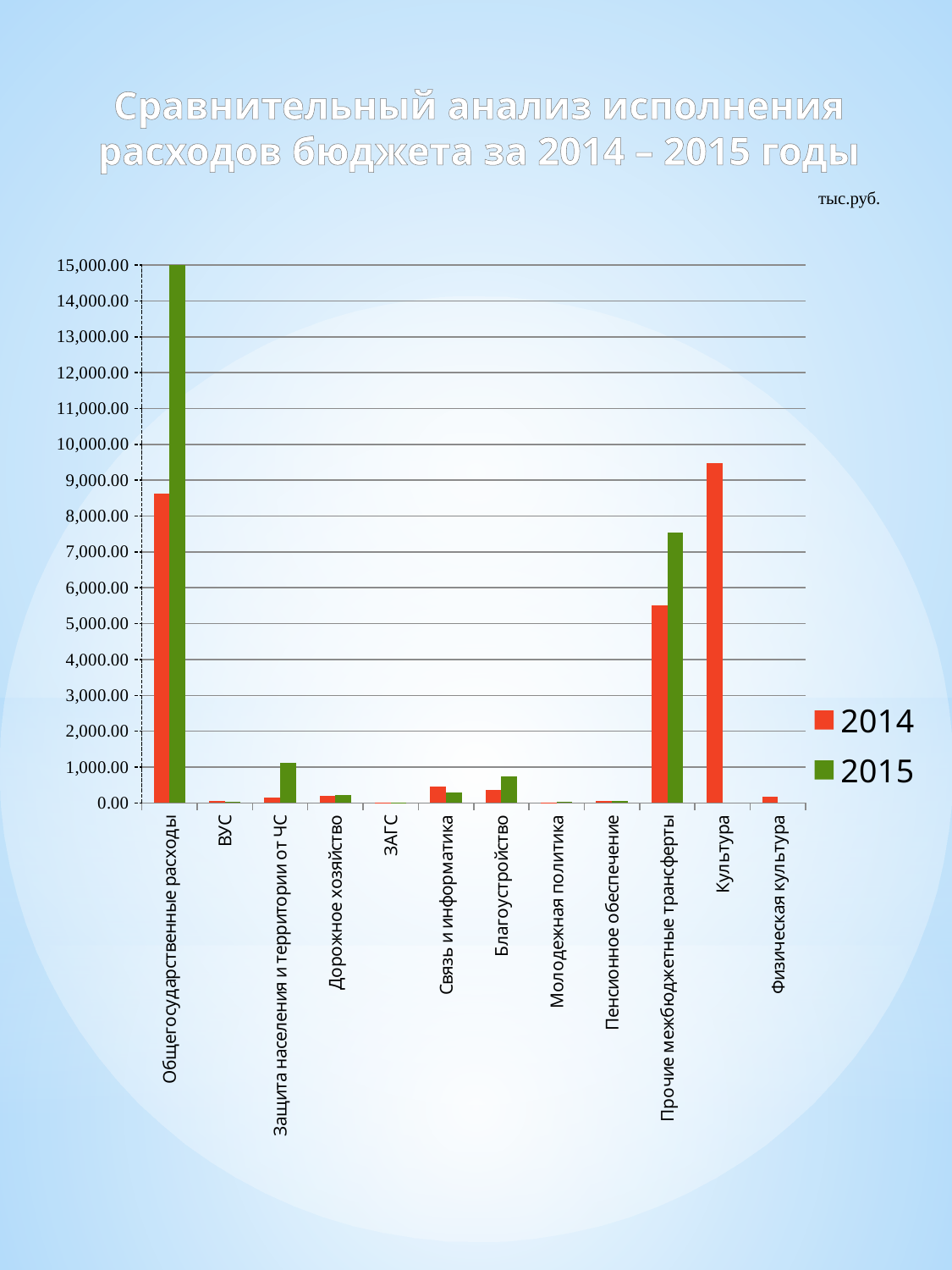
For Связь и информатика, which series has the larger value, 2014 or 2015? 2014 Is the 2015 value for Благоустройство greater or less than 1,000.00? less For Прочие межбюджетные трансферты, which series has the larger value, 2014 or 2015? 2015 Which category has the highest value for the 2015 series? Общегосударственные расходы How many expenditure categories are shown on the x axis? 12 What kind of chart is shown on the slide? bar chart How many series does the legend list? 2 Which category has the highest value for the 2014 series? Культура What unit is indicated above the chart? тыс.руб. Is the 2014 value for Общегосударственные расходы greater or less than 8,000.00? greater Is the 2015 value for Прочие межбюджетные трансферты greater or less than 7,000.00? greater